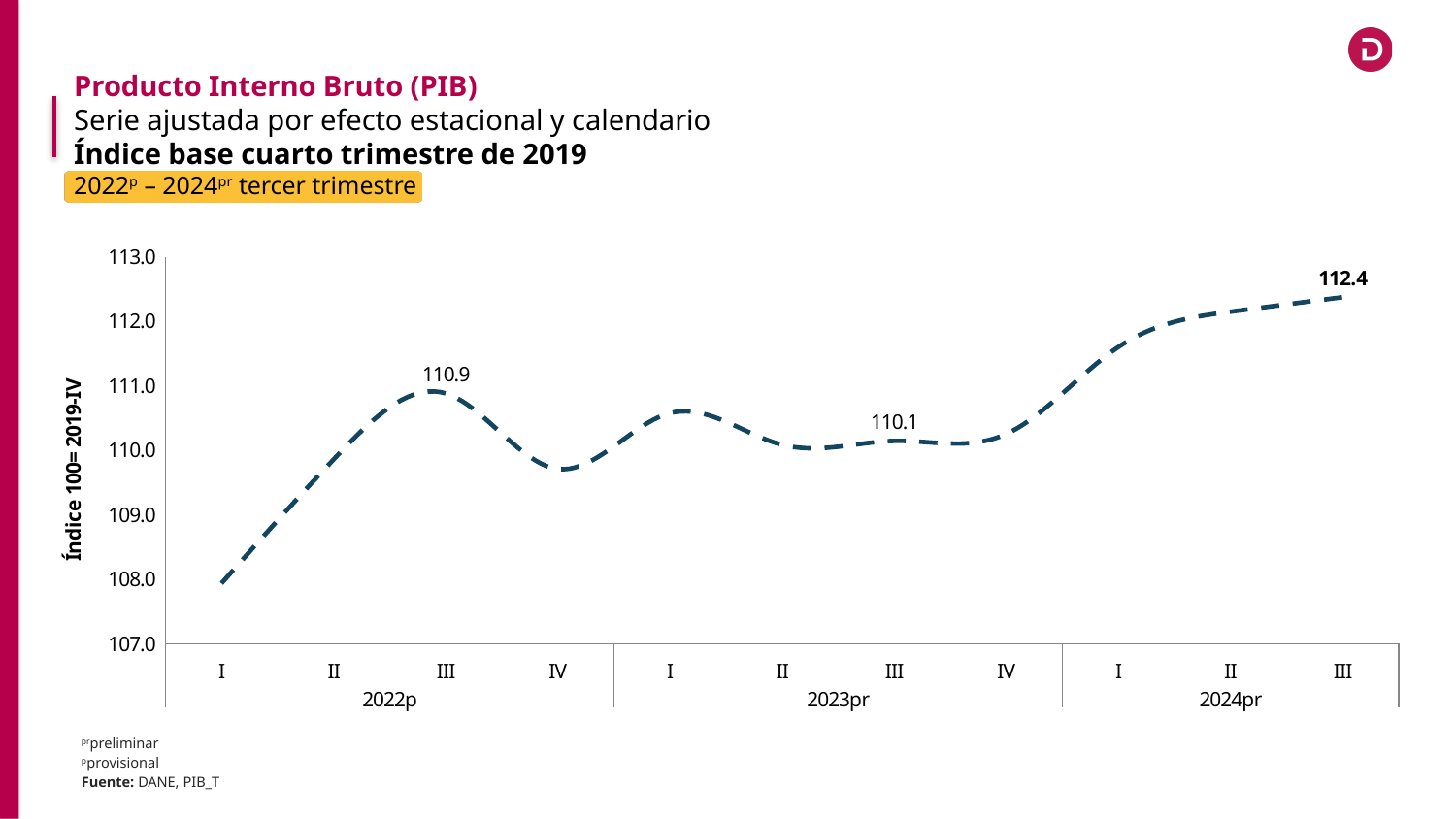
What is the value of the index for the third quarter (III) of 2023pr? 110.1 Which quarter has the highest index value on the chart? III 2024pr Is the index value for I 2024pr greater or less than 111.0? greater What is the value of the index for the third quarter (III) of 2022p? 110.9 How many quarterly data points are plotted on the chart? 11 What is the difference between the index value for III 2024pr and III 2022p? 1.5 Which quarter has the lowest index value on the chart? I 2022p Which is larger, the index value for III 2022p or III 2023pr? III 2022p Is the index value for I 2022p greater or less than 109.0? less What is the difference between the index value for III 2022p and III 2023pr? 0.8 What type of chart is shown on the slide? Line chart What is the value of the index for the third quarter (III) of 2024pr? 112.4